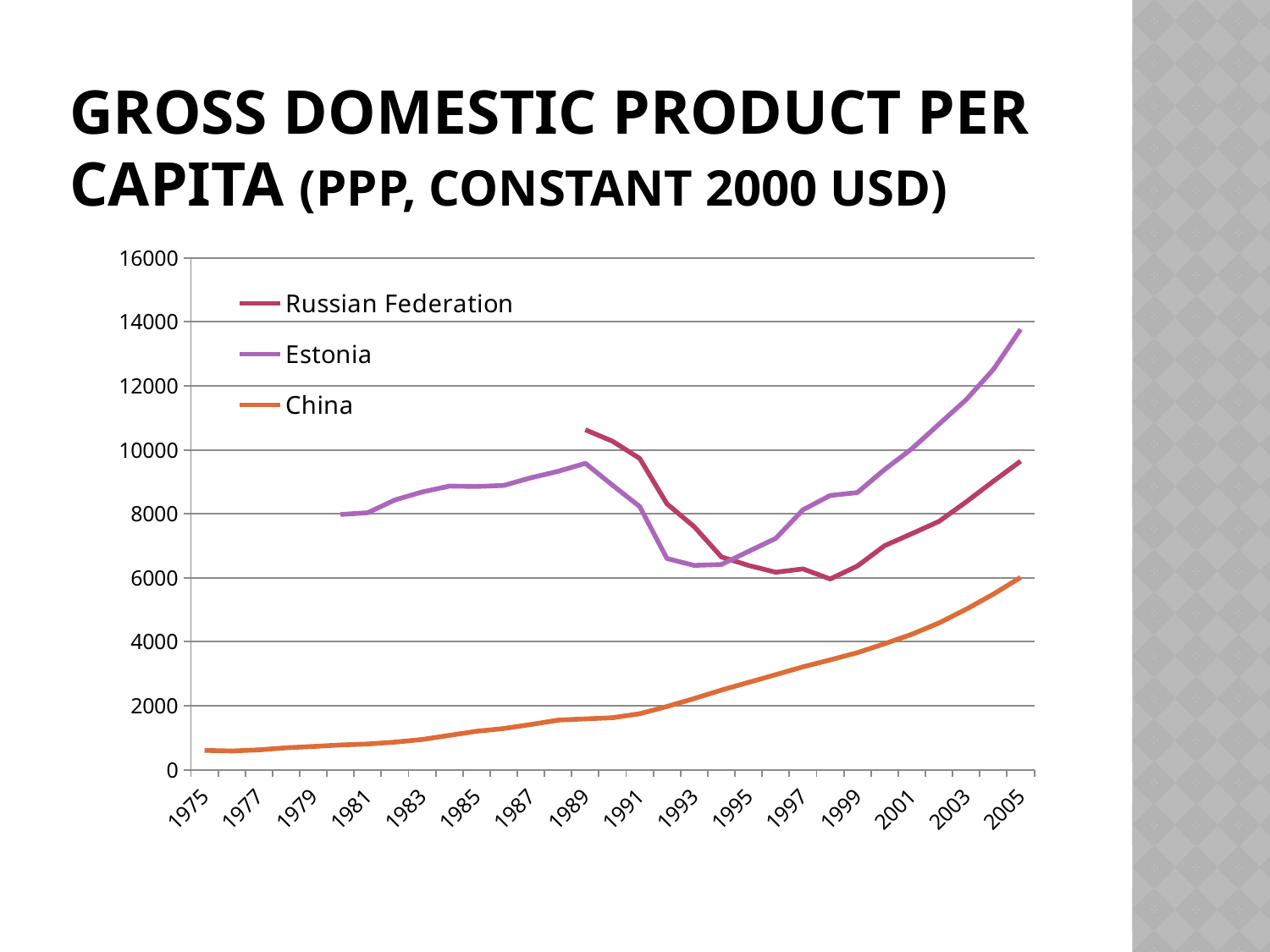
Which series has the highest value in 2005? Estonia Is the value for Estonia in 2005 greater or less than 12000? greater How many series does the legend list? 3 Is the value for the Russian Federation in 1989 greater or less than 10000? greater What kind of chart is shown on the slide? line chart Does the value for China rise or fall from 1975 to 2005? rise In 1991, which is larger: the value for the Russian Federation or the value for Estonia? Russian Federation What is the title of the chart on the slide? GROSS DOMESTIC PRODUCT PER CAPITA (PPP, CONSTANT 2000 USD) Does the value for Estonia rise or fall from 1989 to 1993? fall Is the value for Estonia in 1993 greater or less than 8000? less Which series has the lowest value in 2005? China